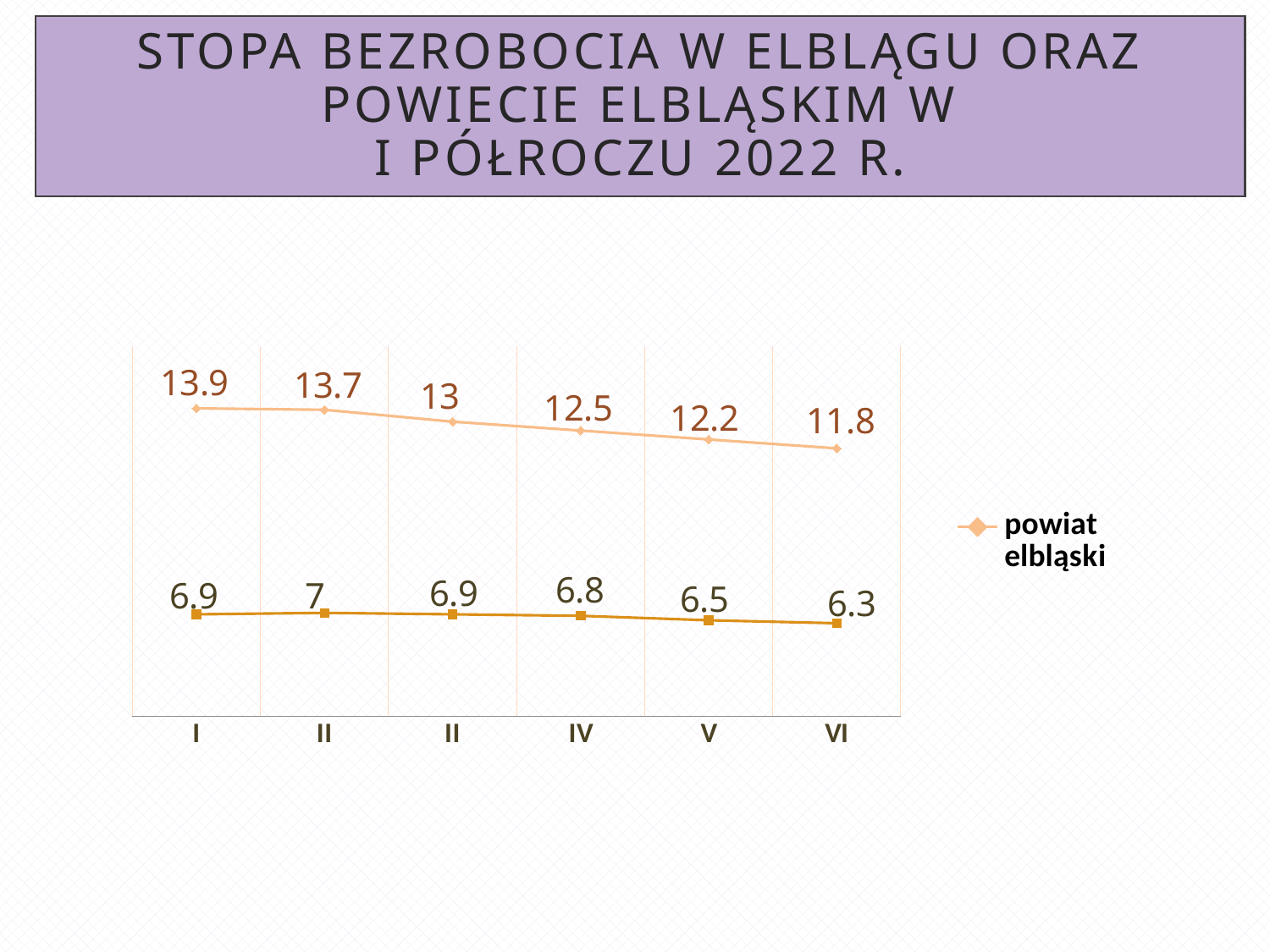
At point IV, which is larger: the powiat elbląski value or the lower line's value? powiat elbląski What is the value for powiat elbląski at point VI? 11.8 Do the powiat elbląski values rise or fall from point I to point VI? fall How many data points does each line have? 6 At which x-axis point is the powiat elbląski value highest? I What is the value of the lower line (square markers) at point V? 6.5 At which x-axis point does the lower line (square markers) reach its highest value? II What is the difference between the powiat elbląski values at point I and point VI? 2.1 At which x-axis point is the powiat elbląski value lowest? VI What kind of chart is shown on the slide? line chart What is the value for powiat elbląski at point I? 13.9